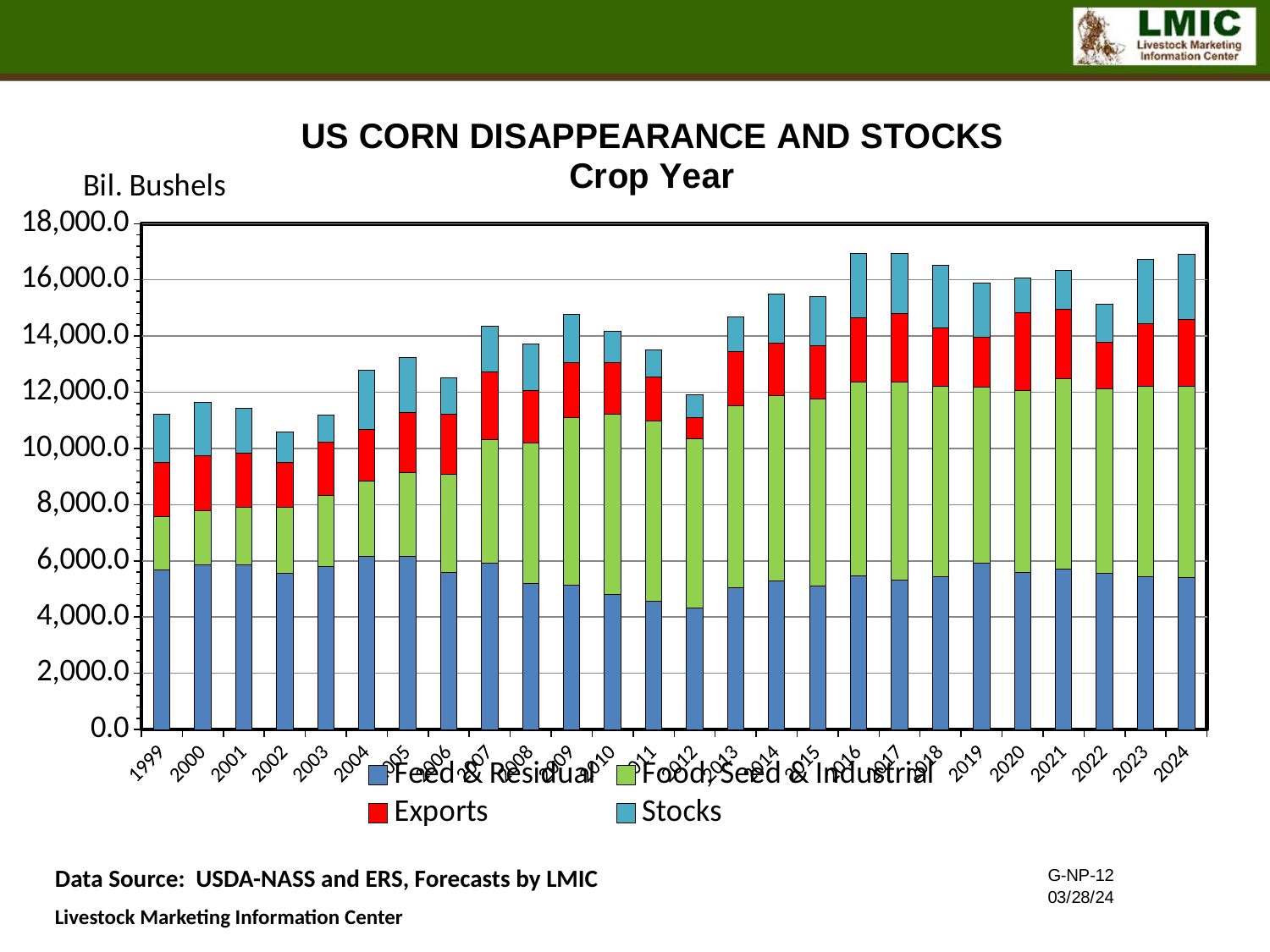
Is the Feed & Residual value for 2011 greater or less than 6,000.0? less Which crop year has the lowest total stacked bar? 2002 Which is larger, the total stacked bar for 2016 or for 2002? 2016 Is the Feed & Residual value for 2012 greater or less than 6,000.0? less How many series does the legend list? 4 Which is larger, the Feed & Residual value for 1999 or for 2012? 1999 What unit is shown on the y axis label? Bil. Bushels Is the total stacked bar for 2002 greater or less than 10,000.0? greater Do the total stacked bars rise or fall from 2012 to 2016? rise What kind of chart is shown on the slide? Stacked bar chart How many crop years are plotted along the x axis? 26